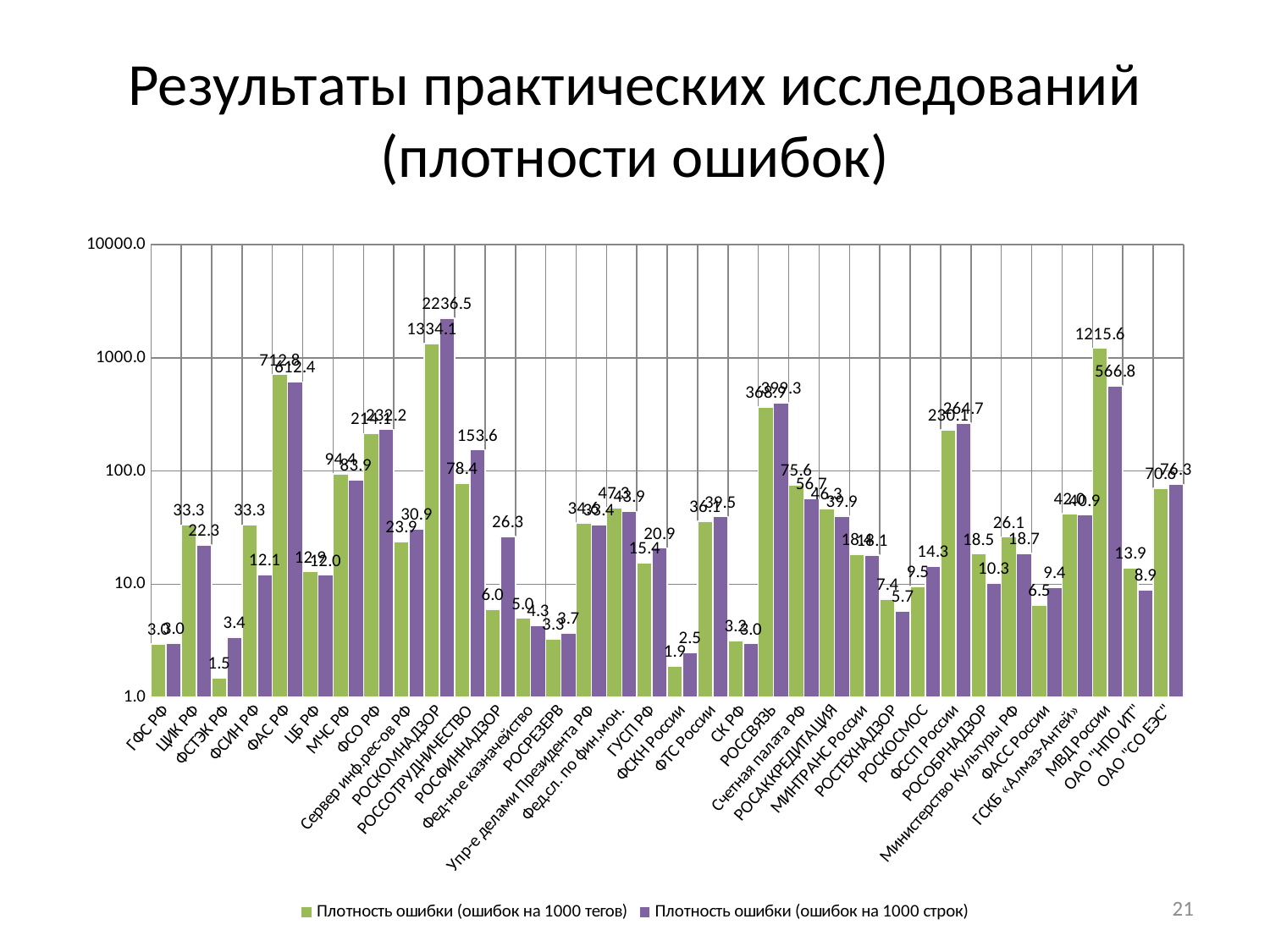
How many series does the legend list? 2 What is the value of 'Плотность ошибки (ошибок на 1000 тегов)' for ФАС РФ? 712.8 What is the title of the chart slide? Результаты практических исследований (плотности ошибок) What is the difference between the two series' values for МВД России (1215.6 and 566.8)? 648.8 For РОСФИННАДЗОР, which series has the larger value: 'ошибок на 1000 тегов' or 'ошибок на 1000 строк'? ошибок на 1000 строк Which category has the highest value of 'Плотность ошибки (ошибок на 1000 строк)'? РОСКОМНАДЗОР What is the value of 'Плотность ошибки (ошибок на 1000 строк)' for РОСКОМНАДЗОР? 2236.5 What is the value of 'Плотность ошибки (ошибок на 1000 строк)' for РОССОТРУДНИЧЕСТВО? 153.6 What is the value of 'Плотность ошибки (ошибок на 1000 тегов)' for МВД России? 1215.6 Which category has the lowest value of 'Плотность ошибки (ошибок на 1000 тегов)'? ФСТЭК РФ Is the value of 'Плотность ошибки (ошибок на 1000 тегов)' for ФССП России greater or less than 100.0? greater What type of chart is shown on the slide? bar chart